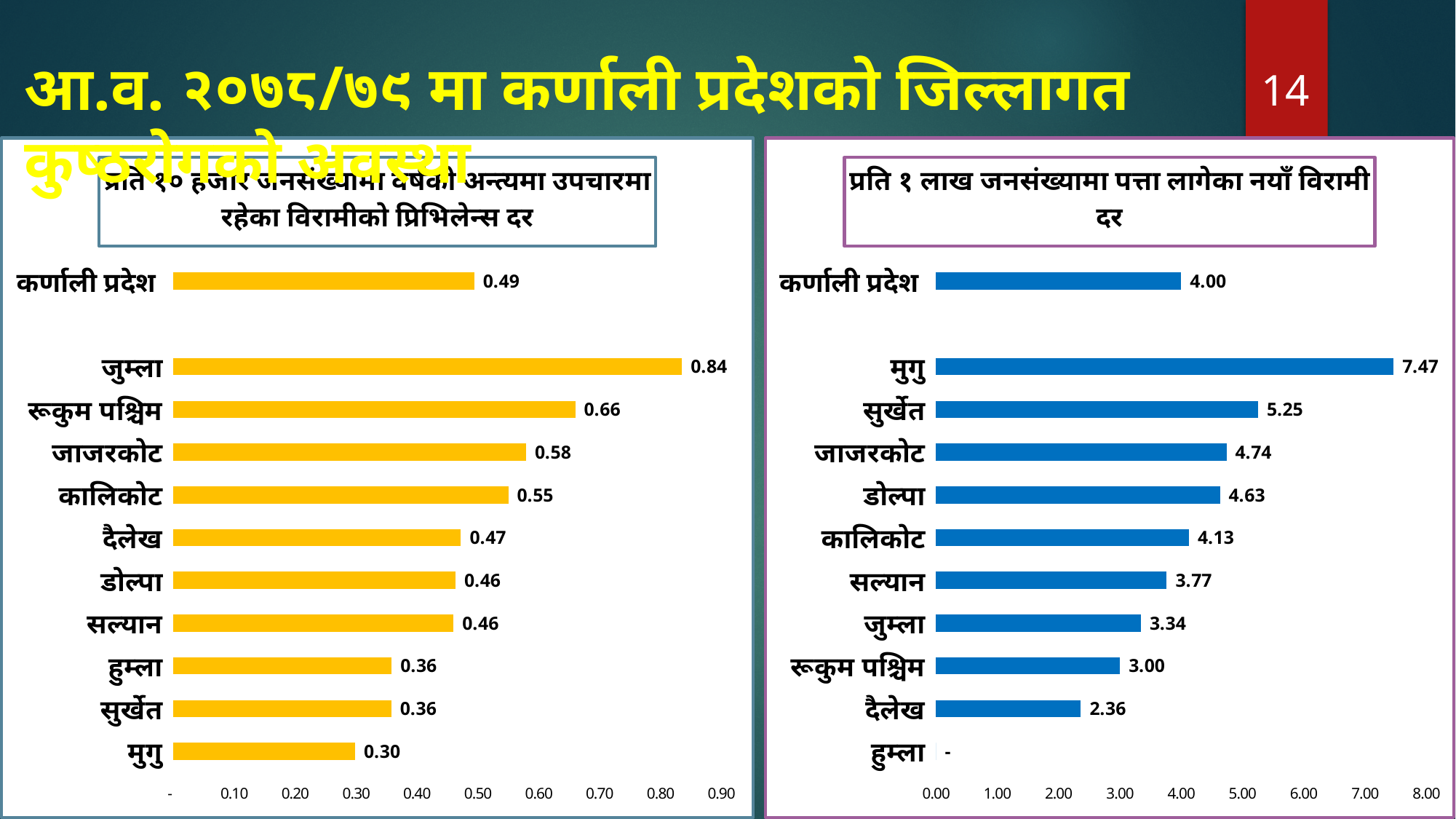
What kind of chart is the right chart? Bar chart In the left chart, which district has the lowest value? मुगु In the right chart, what is the value for मुगु? 7.47 In the left chart, what is the value for जुम्ला? 0.84 In the right chart, which district has the highest value? मुगु In the right chart, what is the value for कर्णाली प्रदेश? 4.00 In the left chart, which is larger, the value for जाजरकोट or the value for कालिकोट? जाजरकोट In the right chart, what is the difference between the values for सुर्खेत and दैलेख? 2.89 In the left chart, what is the value for कर्णाली प्रदेश? 0.49 In the left chart, what is the difference between the values for जुम्ला and रूकुम पश्चिम? 0.18 In the right chart, which is larger, the value for सल्यान or the value for जुम्ला? सल्यान How many categories are listed on the left chart? 11